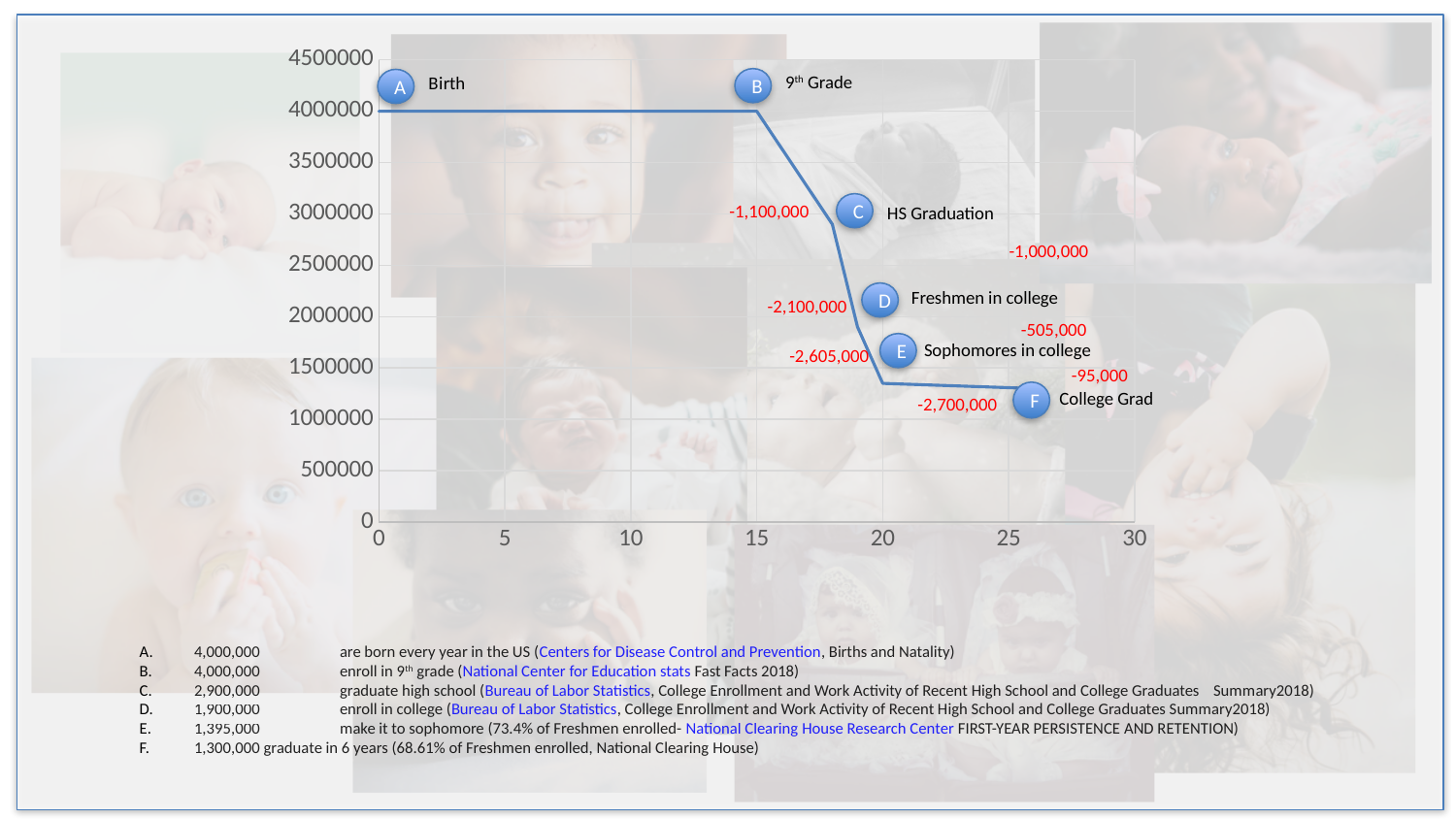
Which is larger, the value for Freshmen in college or the value for Sophomores in college? Freshmen in college What is the difference between the value at 9th Grade and the value at HS Graduation, as labeled in red on the chart? -1,100,000 Which labeled point has the lowest value? F, College Grad What is the value for point E, Sophomores in college? 1,395,000 What is the value for point D, Freshmen in college? 1,900,000 What is the difference between the value at Birth and the value at College Grad, as labeled in red on the chart? -2,700,000 What is the value for point C, HS Graduation? 2,900,000 Do the values rise or fall along the x axis from point B onward? fall What is the value for point F, College Grad? 1,300,000 How many labeled points (A through F) are plotted on the chart? 6 What is the value for point A, Birth? 4,000,000 What kind of chart is shown on the slide? line chart